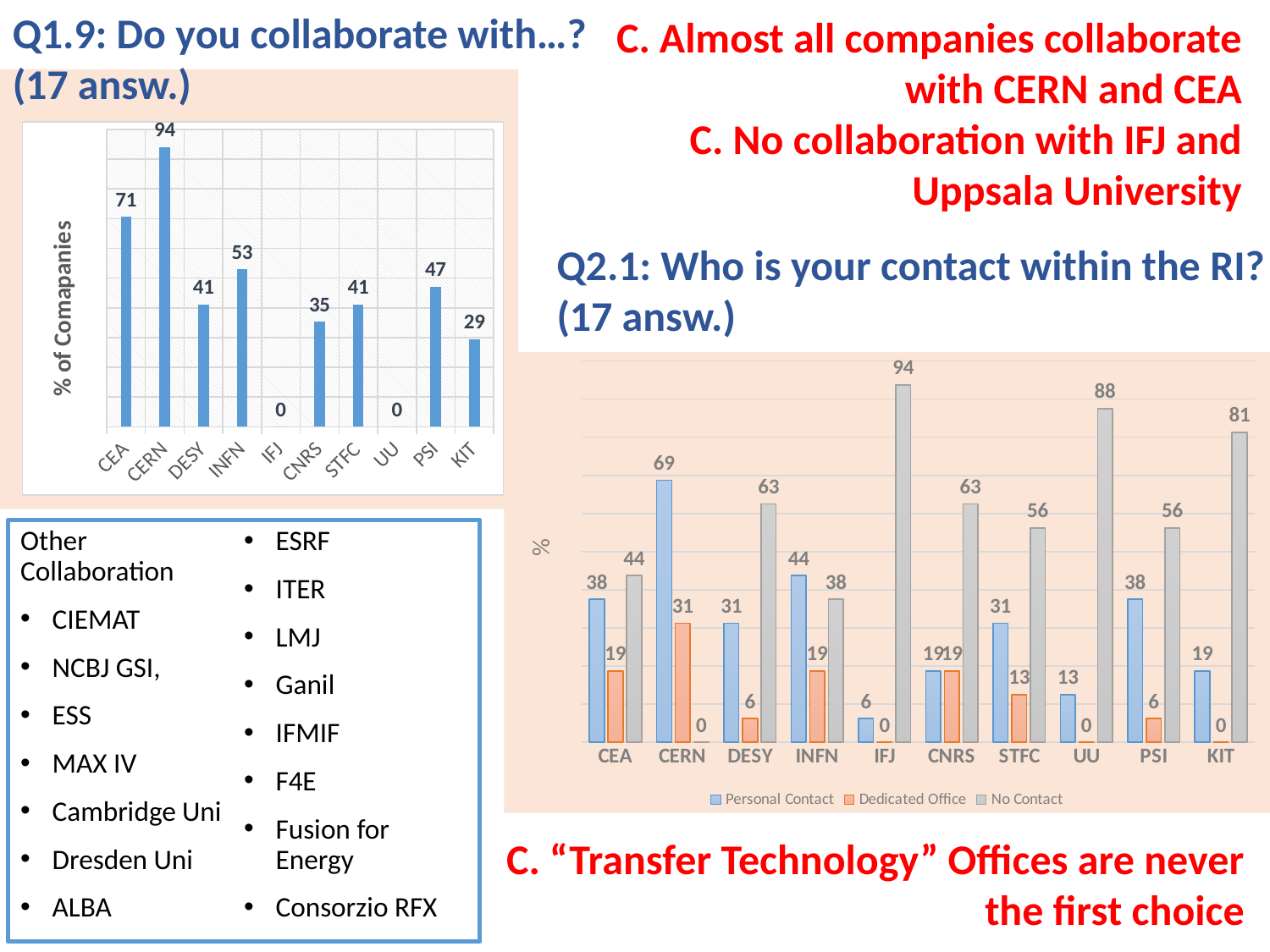
In the Q1.9 chart on the left, what percentage of companies collaborate with CERN? 94 In the Q2.1 chart on the right, what is the No Contact value for IFJ? 94 What kind of chart is the Q2.1 chart on the right? Bar chart In the Q1.9 chart on the left, what is the difference between the values for CEA and KIT? 42 In the Q2.1 chart on the right, which category has the highest Personal Contact value? CERN In the Q2.1 chart on the right, what is the difference between the No Contact values for UU and DESY? 25 In the Q1.9 chart on the left, which category has the highest value? CERN In the Q2.1 chart on the right, what are the three legend entries? Personal Contact, Dedicated Office, No Contact In the Q1.9 chart on the left, how many categories are shown on the x axis? 10 In the Q1.9 chart on the left, which is larger, the value for INFN or the value for PSI? INFN In the Q2.1 chart on the right, how many series does the legend list? 3 In the Q2.1 chart on the right, what is the Dedicated Office value for CERN? 31